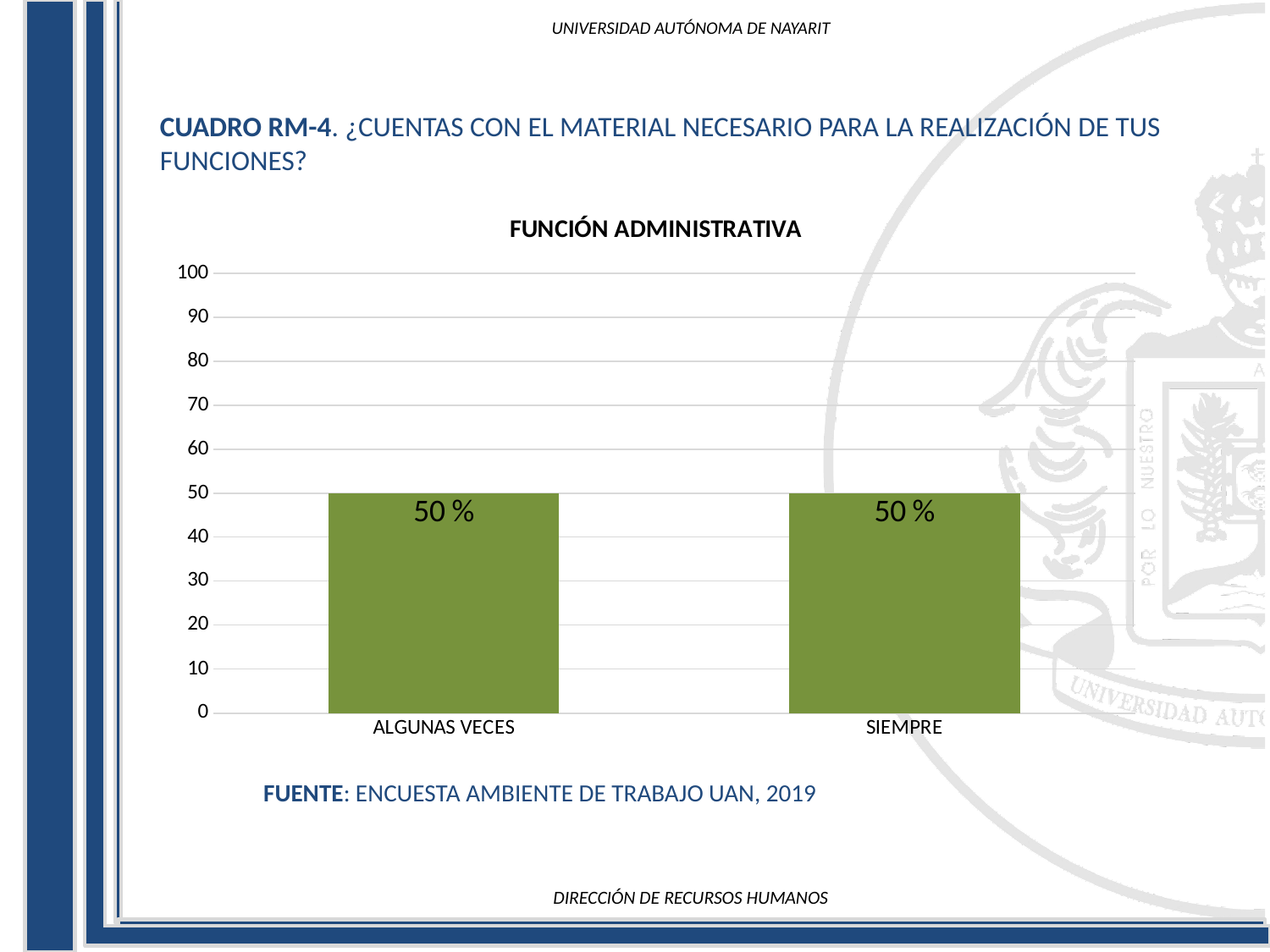
What is the value for ALGUNAS VECES? 50 % What is the difference between the values for ALGUNAS VECES and SIEMPRE? 0 Is the value for ALGUNAS VECES greater or less than 20? greater What kind of chart is shown on the slide? bar chart What is the value for SIEMPRE? 50 % What is the total of the values for ALGUNAS VECES and SIEMPRE? 100 % Is the value for SIEMPRE greater or less than 80? less How many categories are shown on the x axis? 2 What is the title of the chart? FUNCIÓN ADMINISTRATIVA What is the highest value shown on the vertical axis? 100